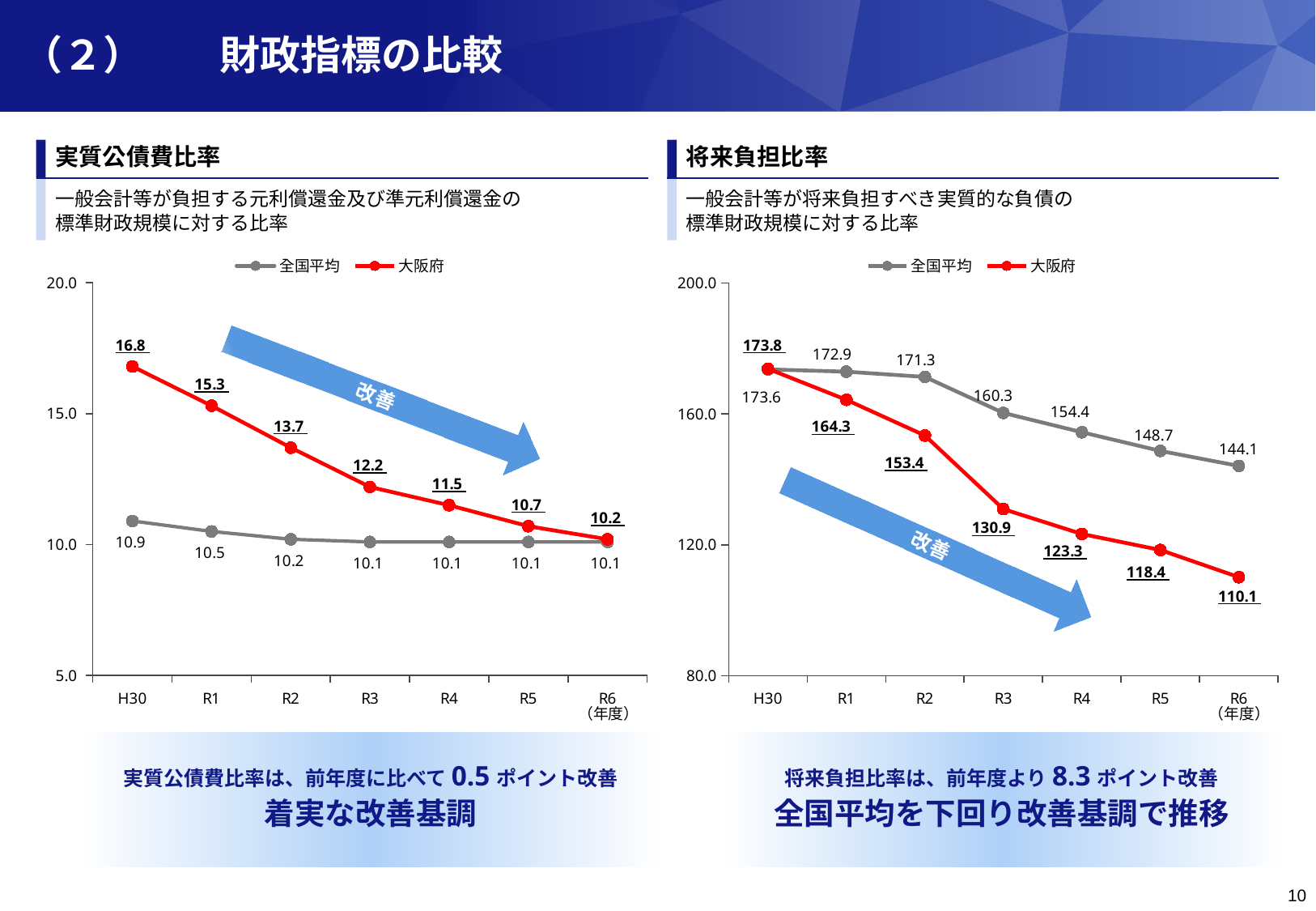
In the 将来負担比率 chart (right), what is the value for 全国平均 in R3? 160.3 In the 実質公債費比率 chart (left), what is the value for 全国平均 in R6? 10.1 What type of chart is the 将来負担比率 chart (right)? line chart In the 実質公債費比率 chart (left), in which year is the 大阪府 value highest? H30 In the 実質公債費比率 chart (left), what is the value for 大阪府 in H30? 16.8 In the 将来負担比率 chart (right), how many years are shown on the x axis? 7 In the 実質公債費比率 chart (left), how many series does the legend list? 2 In the 実質公債費比率 chart (left), does the 大阪府 line rise or fall from H30 to R6? fall In the 将来負担比率 chart (right), which is larger in R2, 全国平均 or 大阪府? 全国平均 In the 将来負担比率 chart (right), what is the difference between 全国平均 and 大阪府 in R6? 34.0 In the 実質公債費比率 chart (left), what is the difference between 大阪府 and 全国平均 in R6? 0.1 In the 将来負担比率 chart (right), what is the value for 大阪府 in R6? 110.1